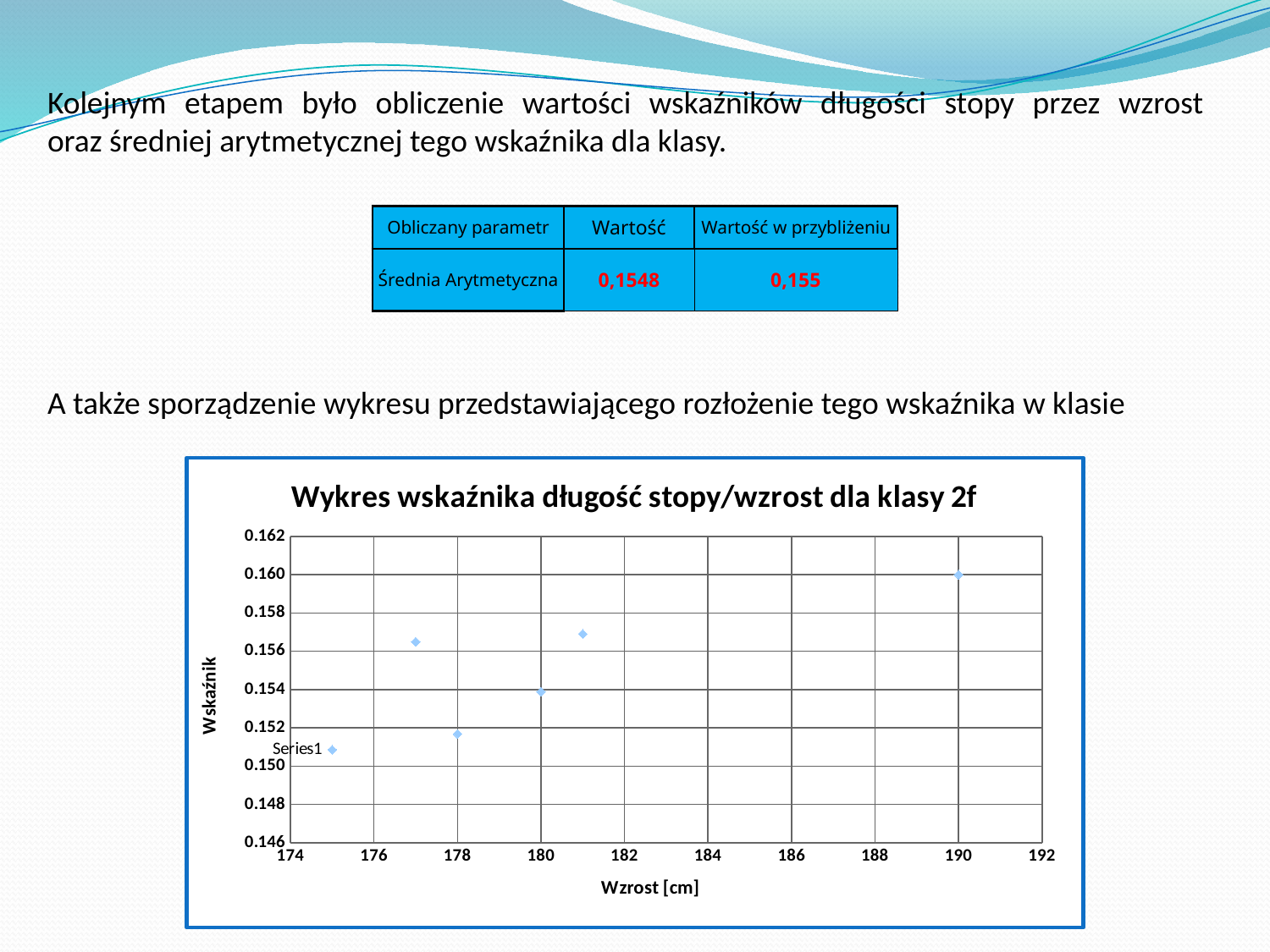
What kind of chart is shown on the slide? scatter chart How many data points are plotted on the chart? 6 At which height (Wzrost) is the plotted Wskaźnik value the highest? 190 What is the title of the chart? Wykres wskaźnika długość stopy/wzrost dla klasy 2f Is the Wskaźnik value for a height of 190 cm greater or less than 0.156? greater Which has the larger Wskaźnik value: the point at 181 cm or the point at 190 cm? 190 cm Is the Wskaźnik value for a height of 180 cm greater or less than 0.156? less Which has the larger Wskaźnik value: the point at 177 cm or the point at 178 cm? 177 cm Is the Wskaźnik value for a height of 177 cm greater or less than 0.154? greater What is the label of the x axis of the chart? Wzrost [cm]